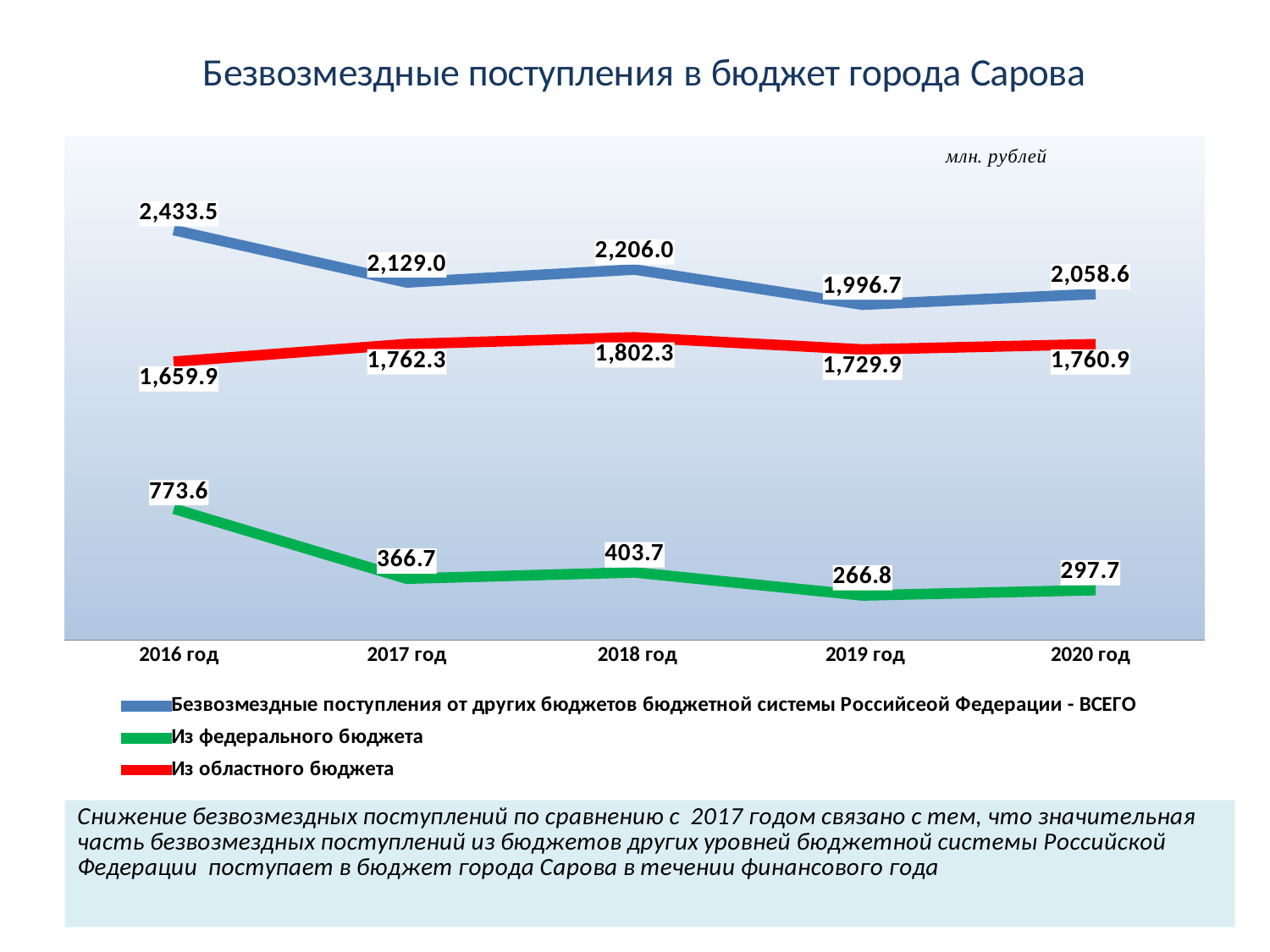
What is the value for 2016 год for the series «Из федерального бюджета»? 773.6 What kind of chart is shown on the slide? Line chart What is the difference between the 2018 год and 2016 год values for «Из областного бюджета»? 142.4 How many years are shown on the x axis? 5 How many series does the legend list? 3 In which year is the value for «Из федерального бюджета» the lowest? 2019 год In which year is the value for «Из областного бюджета» the highest? 2018 год What is the value for 2018 год for the series «Из областного бюджета»? 1,802.3 What is the value for 2020 год for the series «Безвозмездные поступления от других бюджетов бюджетной системы Российсеой Федерации - ВСЕГО»? 2,058.6 What is the difference between the 2016 год and 2017 год values for «Из федерального бюджета»? 406.9 In which year is the total series (ВСЕГО) the highest? 2016 год Which is larger for 2019 год: the value for «Из областного бюджета» or the value for «Из федерального бюджета»? Из областного бюджета